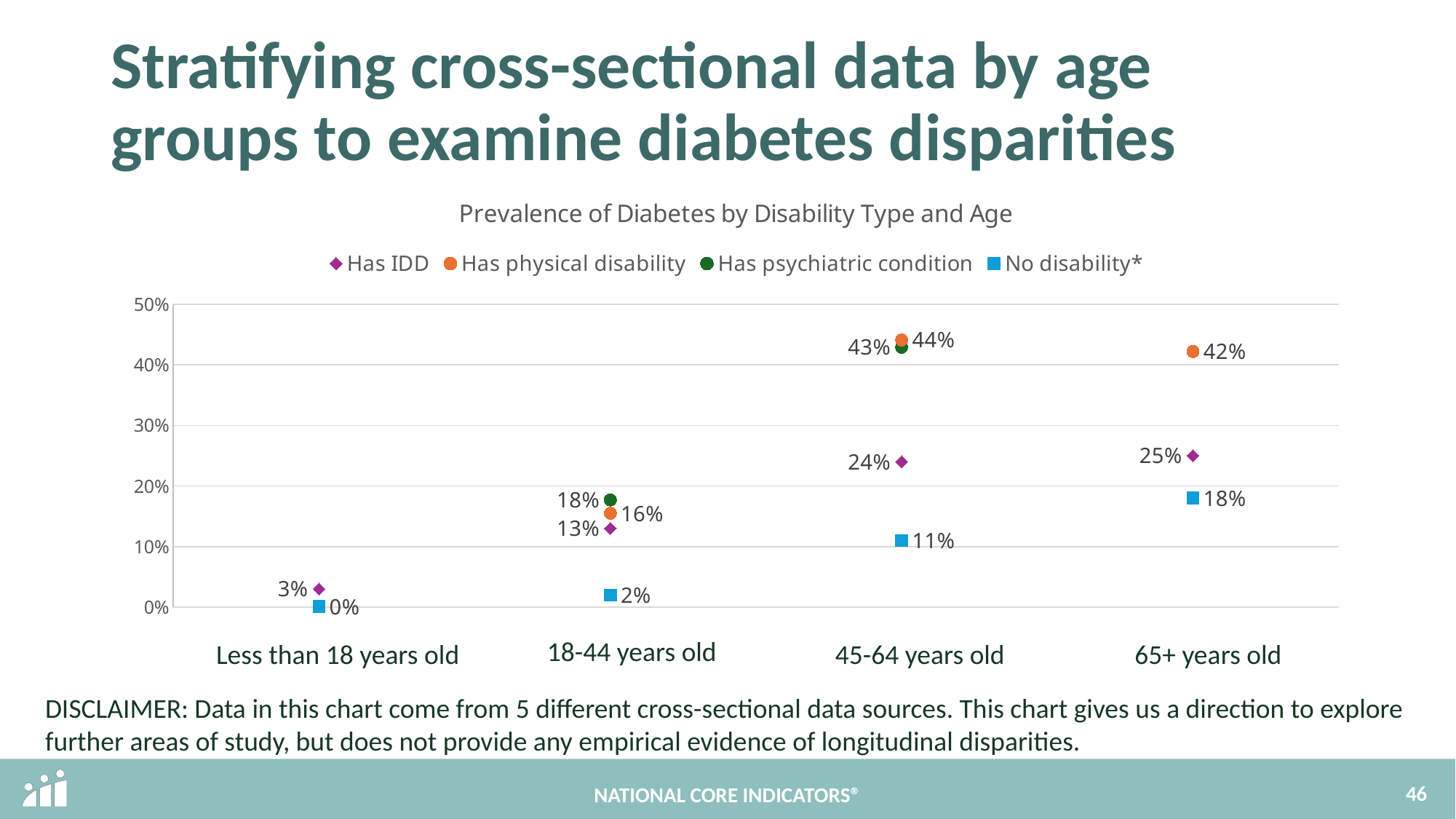
In the 45-64 years old group, what is the difference between the Has physical disability value and the No disability* value? 33 percentage points What is the value for No disability* in the 65+ years old group? 18% How many age groups are shown on the x axis? 4 In which age group is the Has IDD value highest? 65+ years old How many series does the legend list? 4 In which age group is the No disability* value lowest? Less than 18 years old In the 18-44 years old group, which is higher: Has psychiatric condition or Has physical disability? Has psychiatric condition What kind of chart is this? Scatter chart What is the value for Has physical disability in the 18-44 years old group? 16% Does the No disability* value rise or fall as age group increases from left to right? Rises What is the diabetes prevalence for the Has IDD group among 45-64 year olds? 24% What is the value for Has psychiatric condition in the 45-64 years old group? 43%